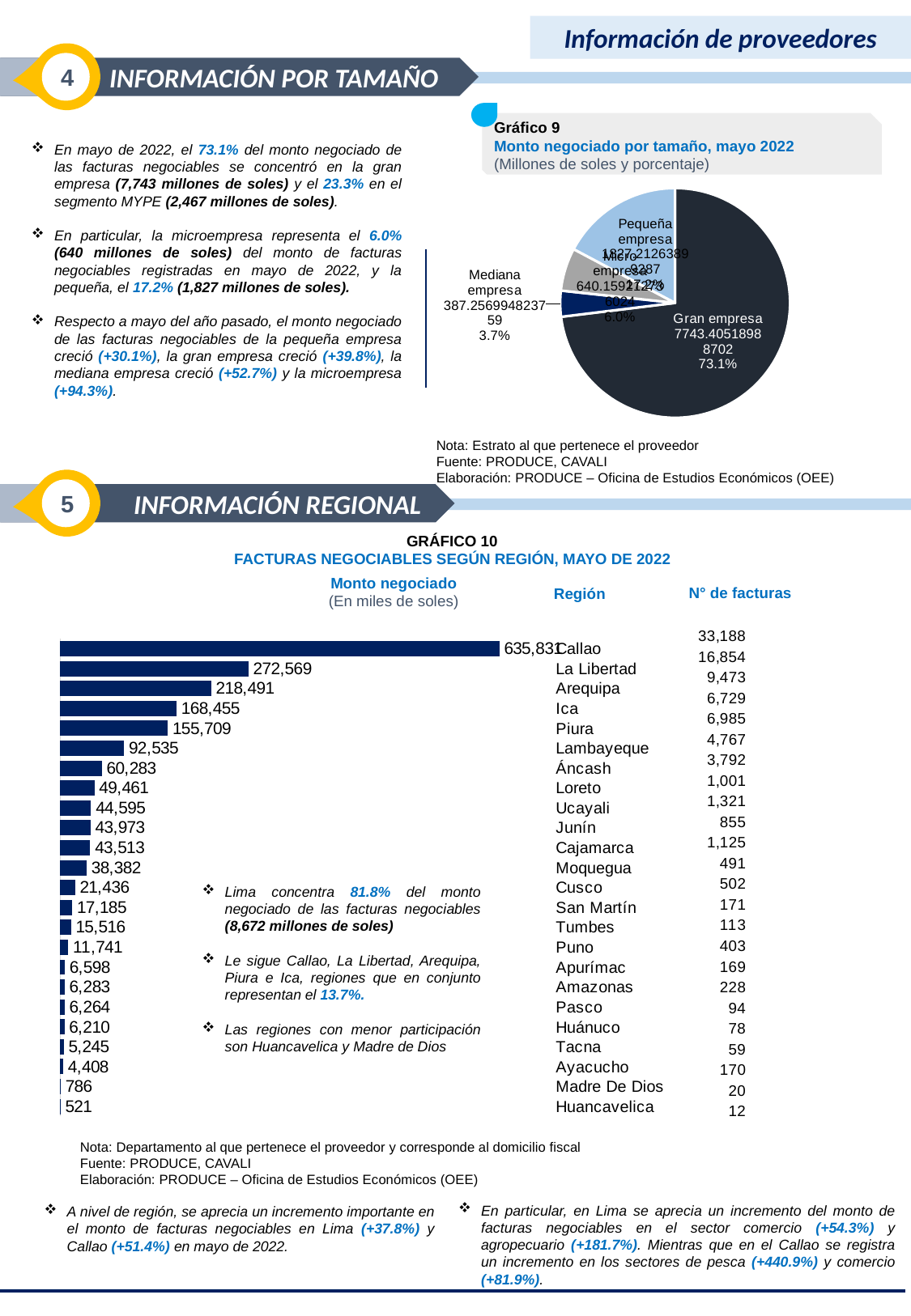
In Gráfico 10 (Facturas negociables según región, mayo de 2022), what kind of chart is used for the Monto negociado? bar chart In Gráfico 9 (Monto negociado por tamaño, mayo 2022), which company size has the largest slice? Gran empresa In Gráfico 9 (Monto negociado por tamaño, mayo 2022), what percentage share does Gran empresa have? 73.1% In Gráfico 10 (Facturas negociables según región, mayo de 2022), which region has the highest Monto negociado? Callao In Gráfico 10 (Facturas negociables según región, mayo de 2022), what is the difference in Monto negociado between La Libertad and Arequipa? 54,078 In Gráfico 10 (Facturas negociables según región, mayo de 2022), what is the Monto negociado for Arequipa? 218,491 In Gráfico 9 (Monto negociado por tamaño, mayo 2022), what kind of chart is shown? pie chart In Gráfico 10 (Facturas negociables según región, mayo de 2022), how many regions are shown? 24 In Gráfico 10 (Facturas negociables según región, mayo de 2022), what is the Monto negociado for Callao? 635,831 In Gráfico 9 (Monto negociado por tamaño, mayo 2022), what percentage share does Mediana empresa have? 3.7% In Gráfico 9 (Monto negociado por tamaño, mayo 2022), which company size has the smallest slice? Mediana empresa In Gráfico 10 (Facturas negociables según región, mayo de 2022), which region has the lowest Monto negociado? Huancavelica